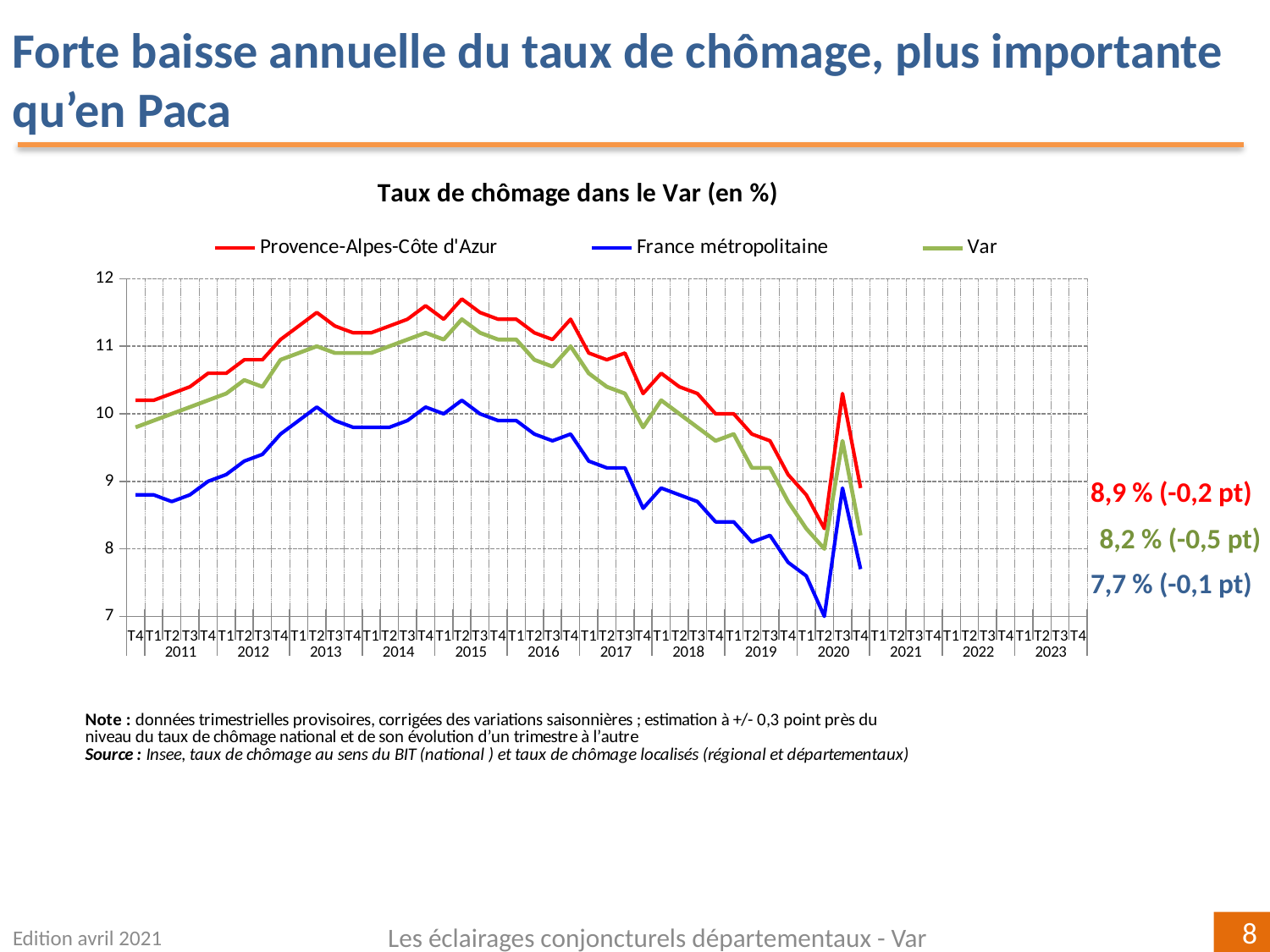
Which series has the lowest values across the whole period? France métropolitaine What is the difference between the latest rates for Provence-Alpes-Côte d'Azur (8,9 %) and France métropolitaine (7,7 %)? 1,2 points Between 2016 and 2019, do the unemployment rates generally rise or fall? fall What is the latest unemployment rate shown for France métropolitaine? 7,7 % What kind of chart is shown on the slide? line chart What is the title of the chart? Taux de chômage dans le Var (en %) What is the latest unemployment rate shown for Provence-Alpes-Côte d'Azur? 8,9 % What is the latest unemployment rate shown for the Var? 8,2 % Is the value for France métropolitaine in T2 2020 greater or less than 8? less How many series does the legend list? 3 What annual change is indicated for the Var's unemployment rate? -0,5 pt At the latest point, which is higher: the rate for Provence-Alpes-Côte d'Azur or the rate for the Var? Provence-Alpes-Côte d'Azur